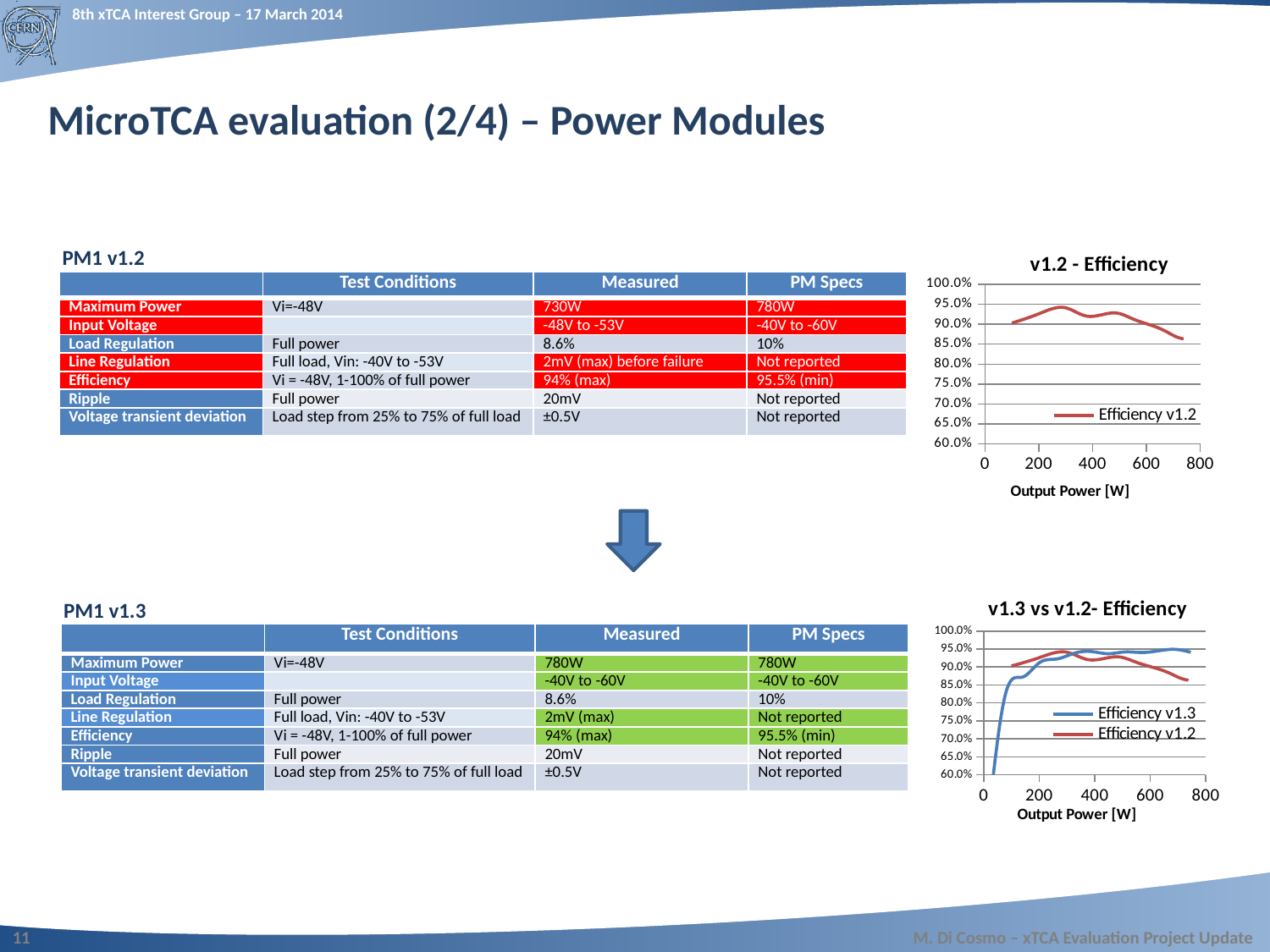
In the 'v1.3 vs v1.2- Efficiency' chart, which colour is the Efficiency v1.3 line? blue How many series does the legend of the 'v1.3 vs v1.2- Efficiency' chart list? 2 In the 'v1.3 vs v1.2- Efficiency' chart, is the Efficiency v1.3 value at 600 W output power greater or less than 90.0%? greater In the 'v1.2 - Efficiency' chart, does the Efficiency v1.2 line rise or fall between 500 W and 700 W output power? fall What kind of chart is the 'v1.2 - Efficiency' chart? line chart What kind of chart is the 'v1.3 vs v1.2- Efficiency' chart? line chart In the 'v1.3 vs v1.2- Efficiency' chart, at 600 W output power, which series has the higher efficiency, Efficiency v1.3 or Efficiency v1.2? Efficiency v1.3 In the 'v1.2 - Efficiency' chart, is the Efficiency v1.2 value at 700 W output power greater or less than 90.0%? less How many series does the legend of the 'v1.2 - Efficiency' chart list? 1 In the 'v1.3 vs v1.2- Efficiency' chart, what is the x-axis label? Output Power [W] In the 'v1.3 vs v1.2- Efficiency' chart, is the Efficiency v1.2 value at 700 W output power greater or less than 90.0%? less